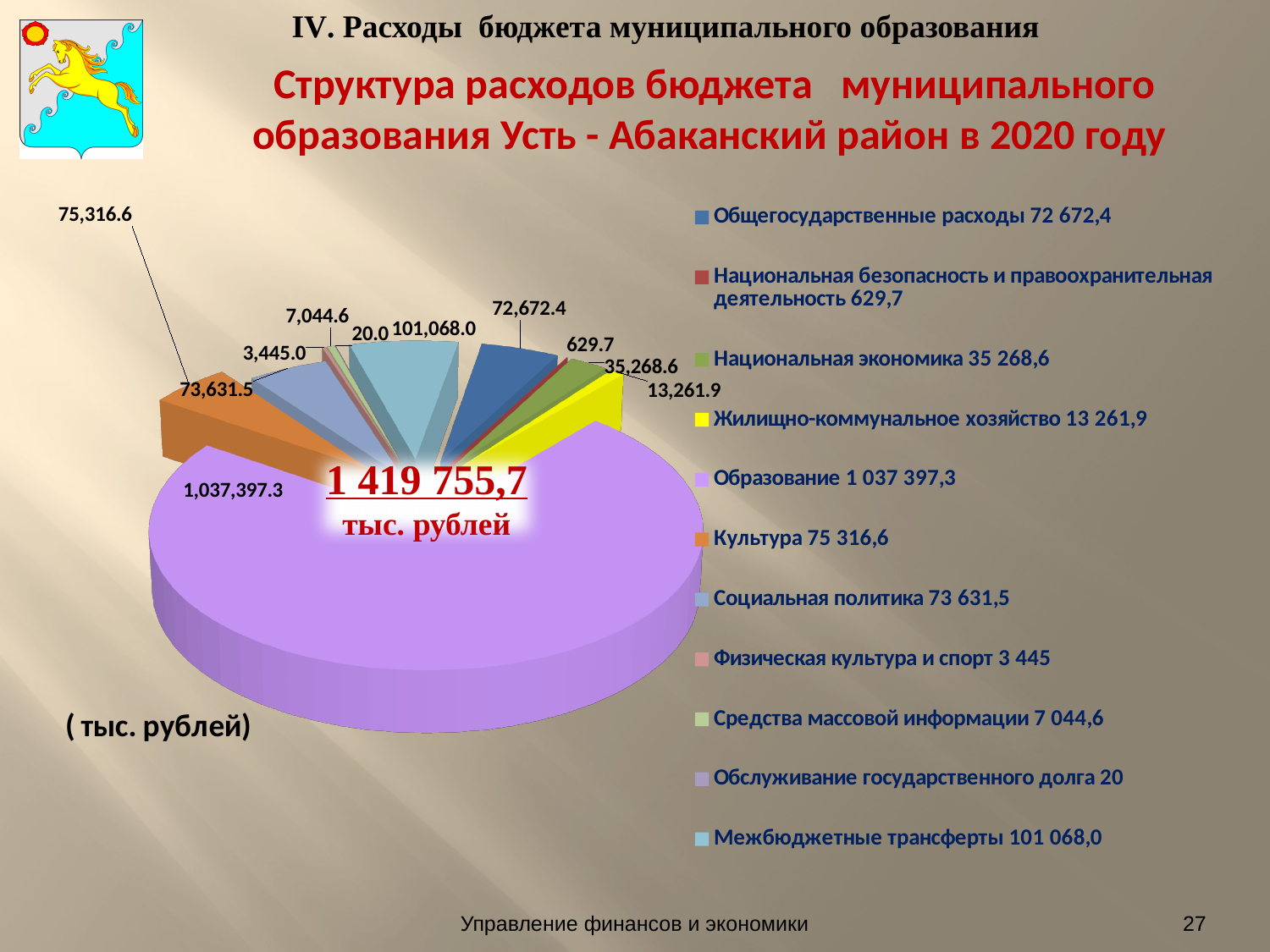
What is the value for Образование (Education) in the pie chart? 1,037,397.3 What is the value for Межбюджетные трансферты in the pie chart? 101,068.0 Which is larger: Межбюджетные трансферты or Общегосударственные расходы? Межбюджетные трансферты How many categories does the pie chart have? 11 Which category has the largest slice in the pie chart? Образование What is the difference between the values for Национальная экономика and Жилищно-коммунальное хозяйство? 22,006.7 What kind of chart is shown on the slide? pie chart Which category has the smallest value in the pie chart? Обслуживание государственного долга What is the value for Обслуживание государственного долга in the pie chart? 20.0 What total is printed in the centre of the pie chart? 1 419 755,7 тыс. рублей What is the difference between the values for Культура and Социальная политика? 1,685.1 What is the value for Культура in the pie chart? 75,316.6